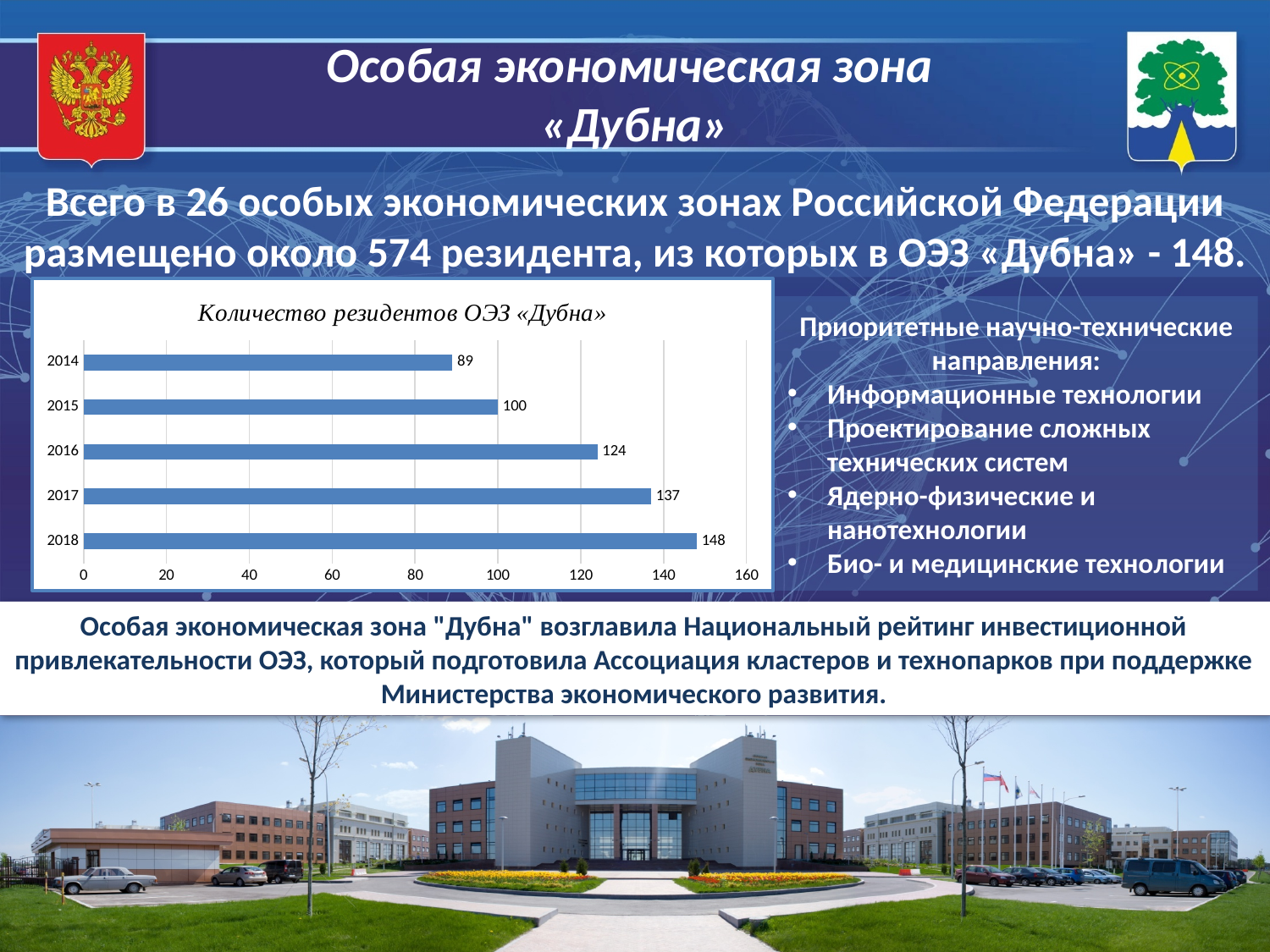
Which year has the highest number of residents in the chart? 2018 What is the number of residents of SEZ «Дубна» in 2016 according to the chart? 124 What is the difference between the values for 2016 and 2015? 24 Which year has a larger value, 2015 or 2017? 2017 What is the title of the chart? Количество резидентов ОЭЗ «Дубна» Is the value for 2018 greater or less than 140? greater Which year has the lowest number of residents in the chart? 2014 What type of chart is used to show the number of residents? bar chart Do the values rise or fall from 2014 to 2018? rise What value does the chart show for 2014? 89 How many years are shown in the chart? 5 By how much did the number of residents increase from 2017 to 2018? 11